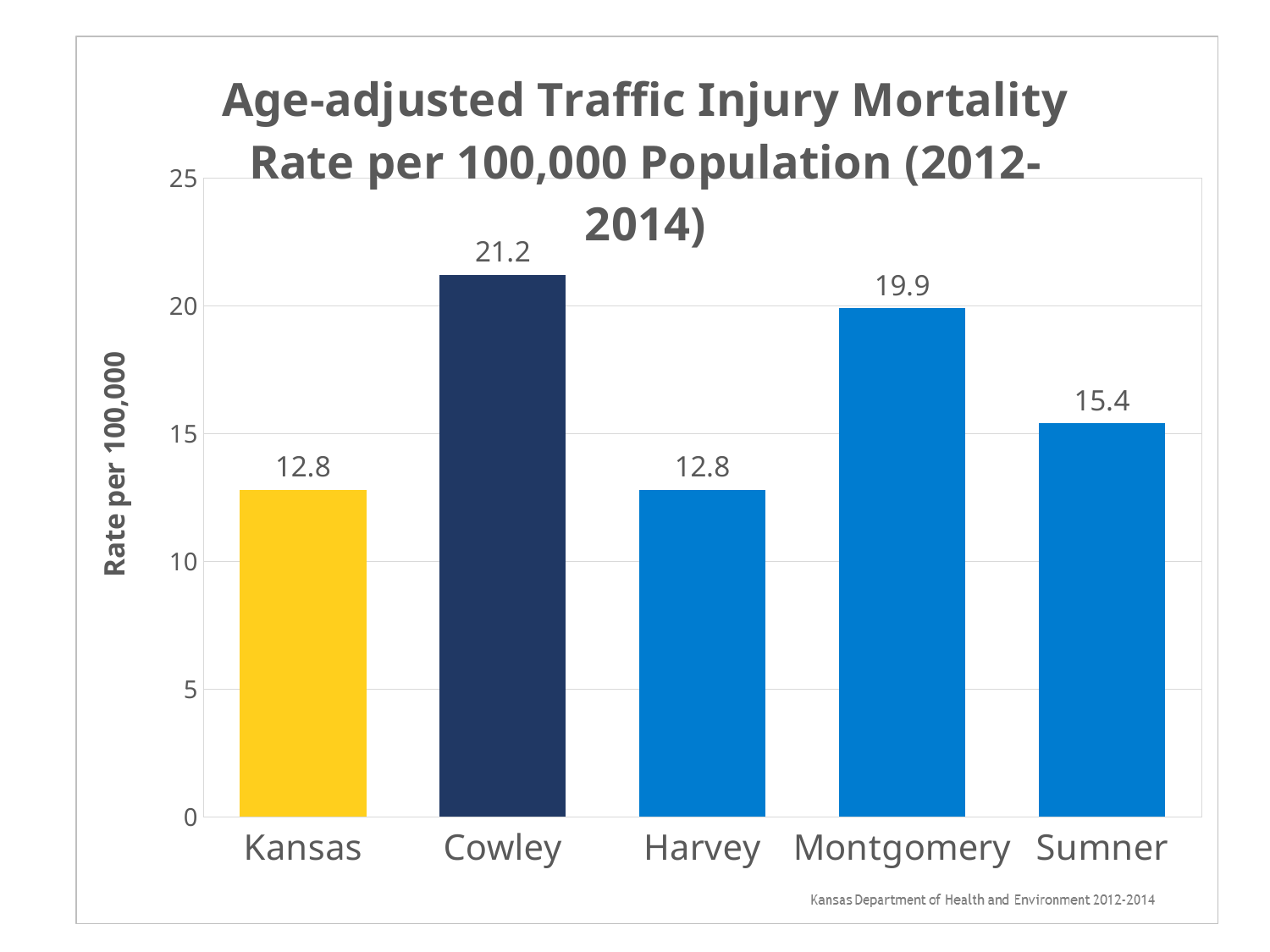
What is the age-adjusted traffic injury mortality rate for Kansas? 12.8 What is the difference between the rates for Cowley and Kansas? 8.4 Which category has the highest traffic injury mortality rate? Cowley What is the label of the y axis? Rate per 100,000 What is the age-adjusted traffic injury mortality rate for Sumner? 15.4 Is the value for Montgomery greater or less than 15? greater Which has a higher rate, Sumner or Harvey? Sumner What is the age-adjusted traffic injury mortality rate for Cowley? 21.2 What is the age-adjusted traffic injury mortality rate for Montgomery? 19.9 What kind of chart is shown on the slide? Bar chart How many categories are shown on the x axis? 5 What is the difference between the rates for Montgomery and Sumner? 4.5